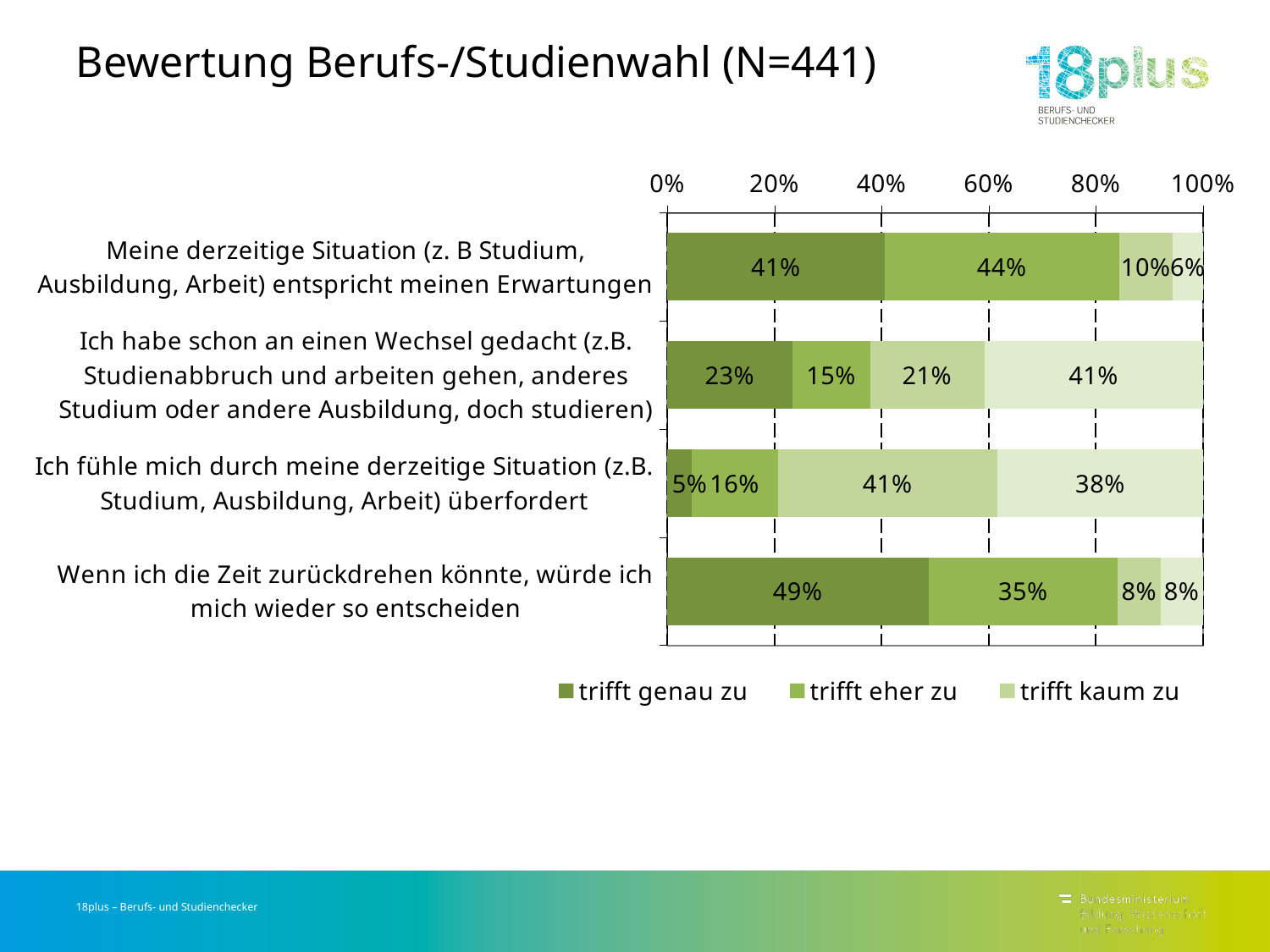
What type of chart is shown on the slide? stacked bar chart Which statement has the lowest 'trifft genau zu' value? Ich fühle mich durch meine derzeitige Situation (z.B. Studium, Ausbildung, Arbeit) überfordert What is the 'trifft genau zu' value for 'Wenn ich die Zeit zurückdrehen könnte, würde ich mich wieder so entscheiden'? 49% What is the difference between the 'trifft genau zu' values for 'Wenn ich die Zeit zurückdrehen könnte' and 'Ich habe schon an einen Wechsel gedacht'? 26% Which statement has the highest 'trifft genau zu' value? Wenn ich die Zeit zurückdrehen könnte, würde ich mich wieder so entscheiden How many series does the legend list? 3 What is the title of the chart slide? Bewertung Berufs-/Studienwahl (N=441) Which is larger: the 'trifft eher zu' value for 'Meine derzeitige Situation entspricht meinen Erwartungen' or for 'Wenn ich die Zeit zurückdrehen könnte'? Meine derzeitige Situation entspricht meinen Erwartungen What is the 'trifft kaum zu' value for 'Ich habe schon an einen Wechsel gedacht'? 21% How many statements (categories) are plotted in the chart? 4 What is the 'trifft eher zu' value for 'Meine derzeitige Situation (z. B Studium, Ausbildung, Arbeit) entspricht meinen Erwartungen'? 44% What is the 'trifft genau zu' value for 'Ich fühle mich durch meine derzeitige Situation überfordert'? 5%